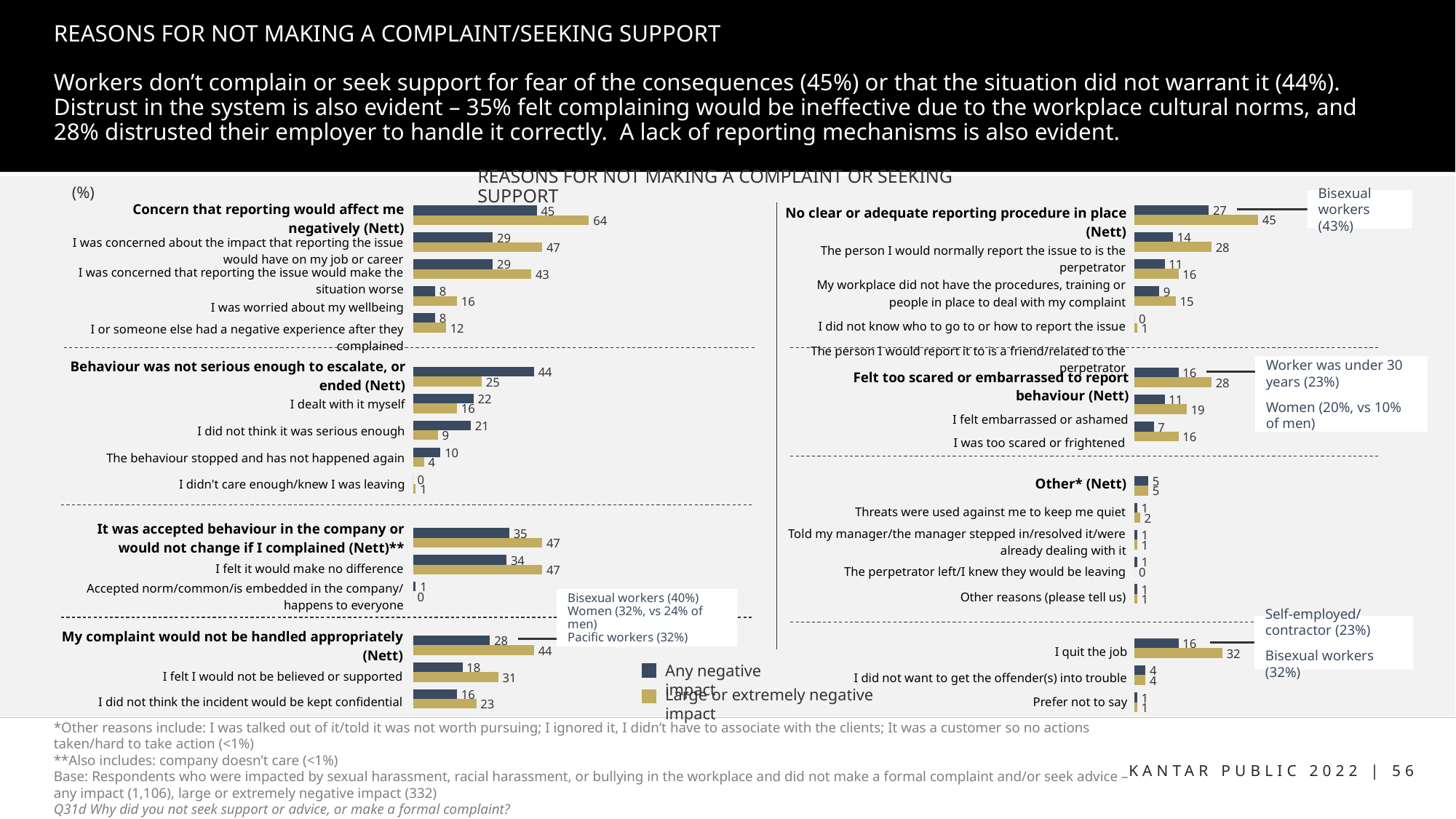
In the left chart, for 'Behaviour was not serious enough to escalate, or ended (Nett)', which series has the larger value: 'Any negative impact' or 'Large or extremely negative impact'? Any negative impact In the right chart, what is the 'Any negative impact' value for 'The person I would normally report the issue to is the perpetrator'? 14 What type of chart is used on this slide? Bar chart In the right chart, what is the 'Large or extremely negative impact' value for 'I quit the job'? 32 In the left chart, what is the 'Large or extremely negative impact' value for 'I felt it would make no difference'? 47 In the left chart, which category has the highest 'Large or extremely negative impact' value? Concern that reporting would affect me negatively (Nett) In the left chart, what is the difference between the 'Large or extremely negative impact' and 'Any negative impact' values for 'Concern that reporting would affect me negatively (Nett)'? 19 In the left chart, what is the 'Any negative impact' value for 'Concern that reporting would affect me negatively (Nett)'? 45 In the right chart, what is the 'Any negative impact' value for 'I was too scared or frightened'? 7 In the right chart, what is the difference between the 'Large or extremely negative impact' and 'Any negative impact' values for 'Felt too scared or embarrassed to report behaviour (Nett)'? 12 In the right chart, which category has the highest 'Any negative impact' value? No clear or adequate reporting procedure in place (Nett) How many series does the legend list? 2